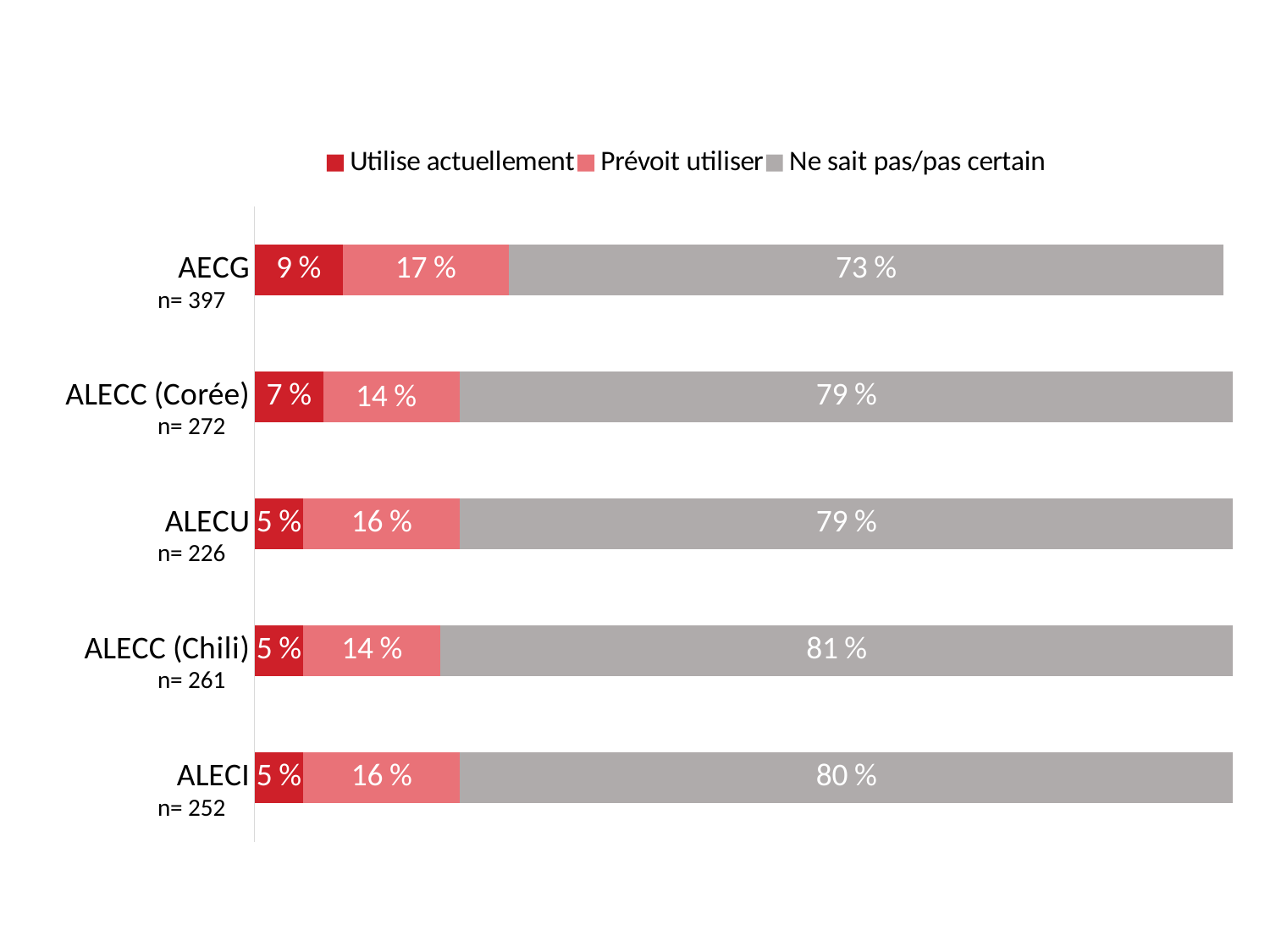
What is the value for "Ne sait pas/pas certain" for ALECC (Chili)? 81 % Which category has the lowest value for "Ne sait pas/pas certain"? AECG What is the total of the stacked bar for ALECI? 101 % What is the value for "Prévoit utiliser" for ALECC (Corée)? 14 % How many categories are shown on the chart? 5 Which category has the highest value for "Utilise actuellement"? AECG What is the difference between the "Ne sait pas/pas certain" values for ALECC (Chili) and AECG? 8 % How many series does the legend list? 3 What is the value for "Utilise actuellement" for AECG? 9 % What is the sample size (n) shown for ALECU? n= 226 Which is larger: the "Prévoit utiliser" value for AECG or for ALECU? AECG What kind of chart is shown on the slide? Stacked bar chart